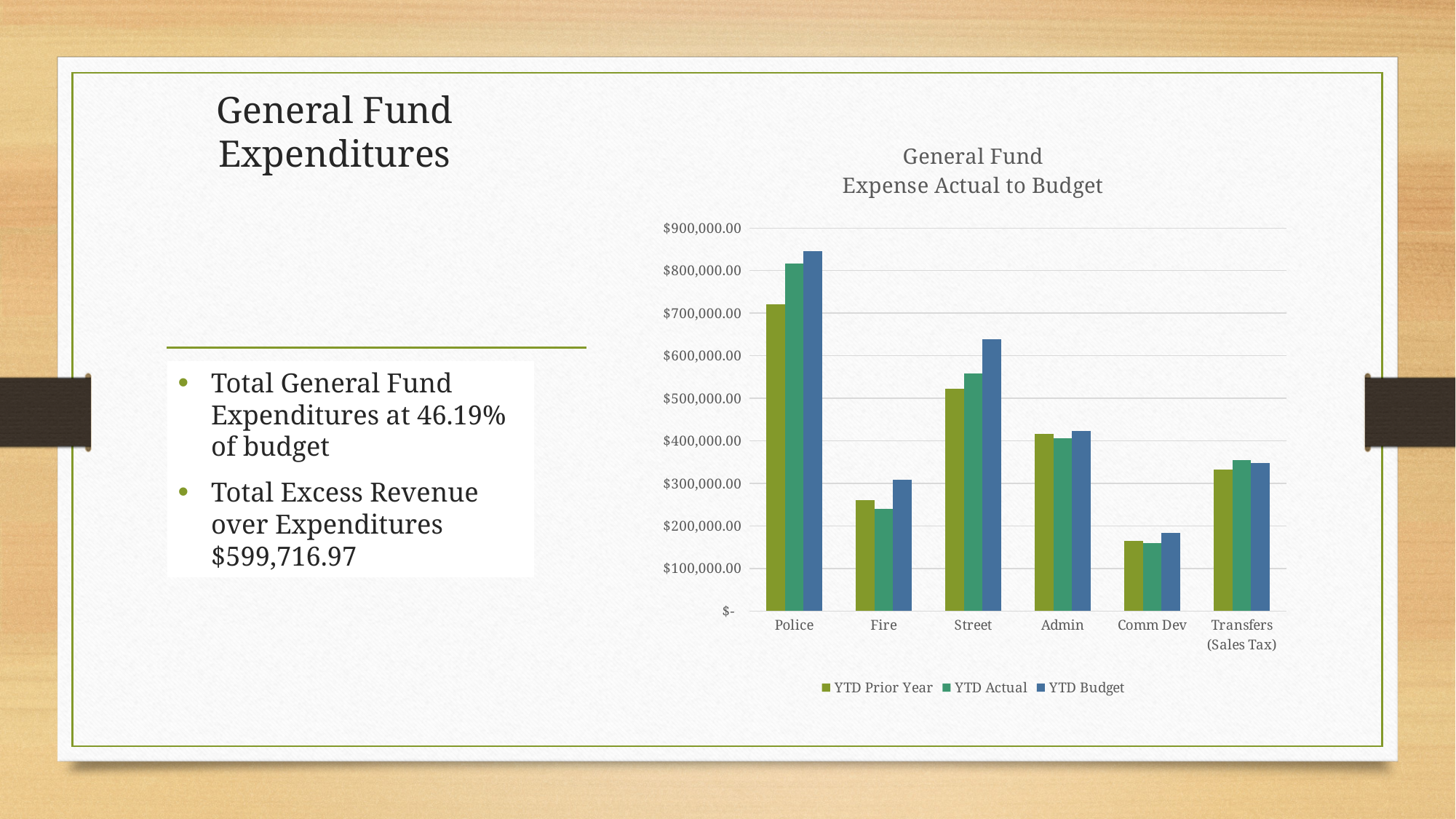
What are the three series listed in the chart legend? YTD Prior Year, YTD Actual, YTD Budget How many series does the legend of the chart list? 3 For Street, which is larger: YTD Actual or YTD Budget? YTD Budget Is the YTD Actual value for Fire greater or less than $300,000.00? less What is the title of the chart? General Fund Expense Actual to Budget For Fire, which is larger: YTD Prior Year or YTD Actual? YTD Prior Year Which category has the lowest YTD Actual value? Comm Dev Is the YTD Budget value for Street greater or less than $600,000.00? greater Is the YTD Budget value for Police greater or less than $800,000.00? greater How many categories are shown along the x axis of the chart? 6 What kind of chart is shown on the slide? Bar chart Which category has the highest YTD Budget value? Police